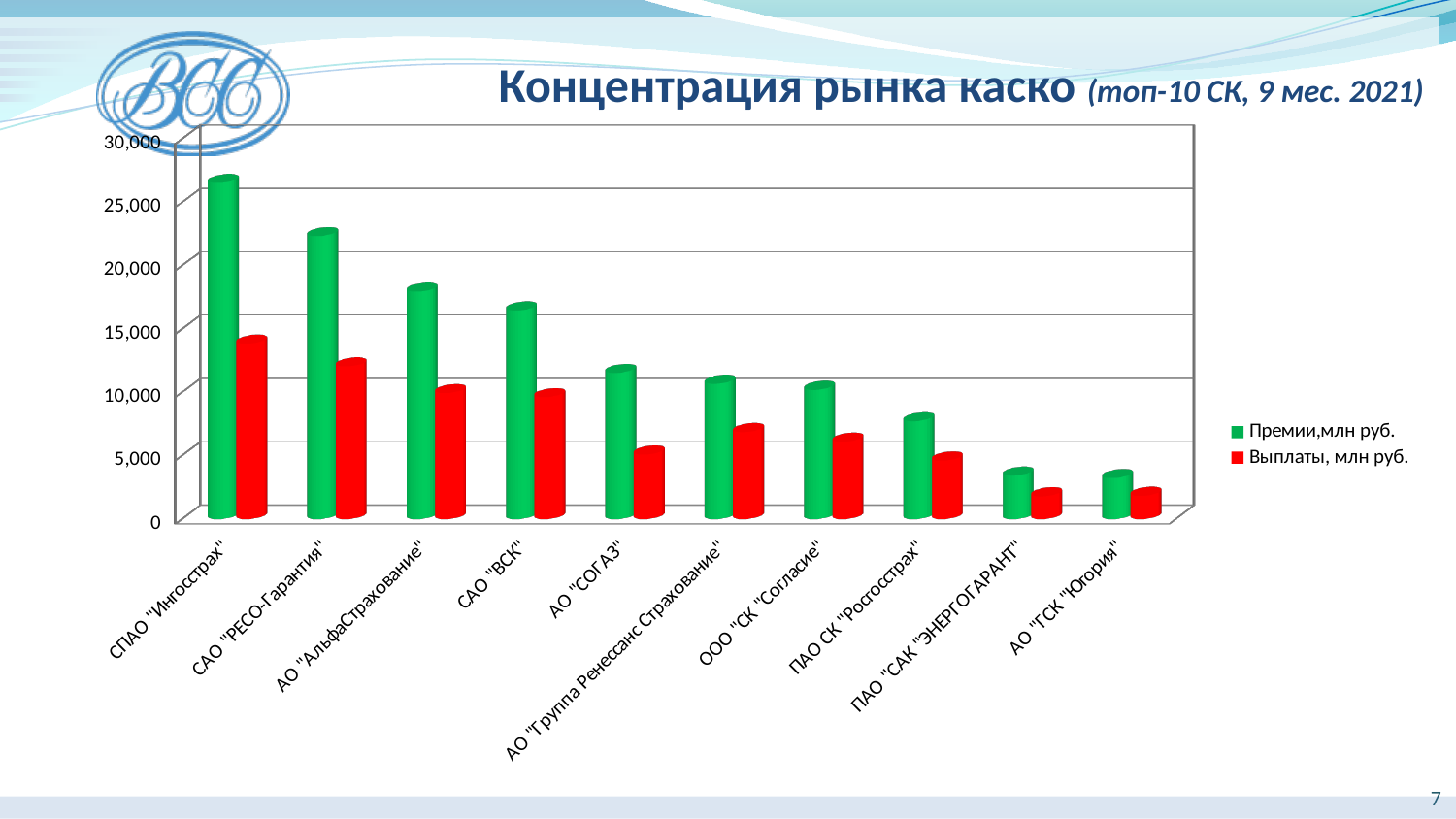
Which colour represents Выплаты, млн руб. in the chart? Red Which is larger for САО "ВСК": Премии or Выплаты? Премии How many series does the chart legend list? 2 What kind of chart is shown on the slide? Bar chart How many insurance companies are shown on the x axis of the chart? 10 Is the Премии value for СПАО "Ингосстрах" greater or less than 25,000? greater Is the Выплаты value for СПАО "Ингосстрах" greater or less than 15,000? less Is the Премии value for ПАО СК "Росгосстрах" greater or less than 10,000? less Which company has the highest value for Премии, млн руб.? СПАО "Ингосстрах" Do the Премии values rise or fall moving from left to right along the x axis? Fall